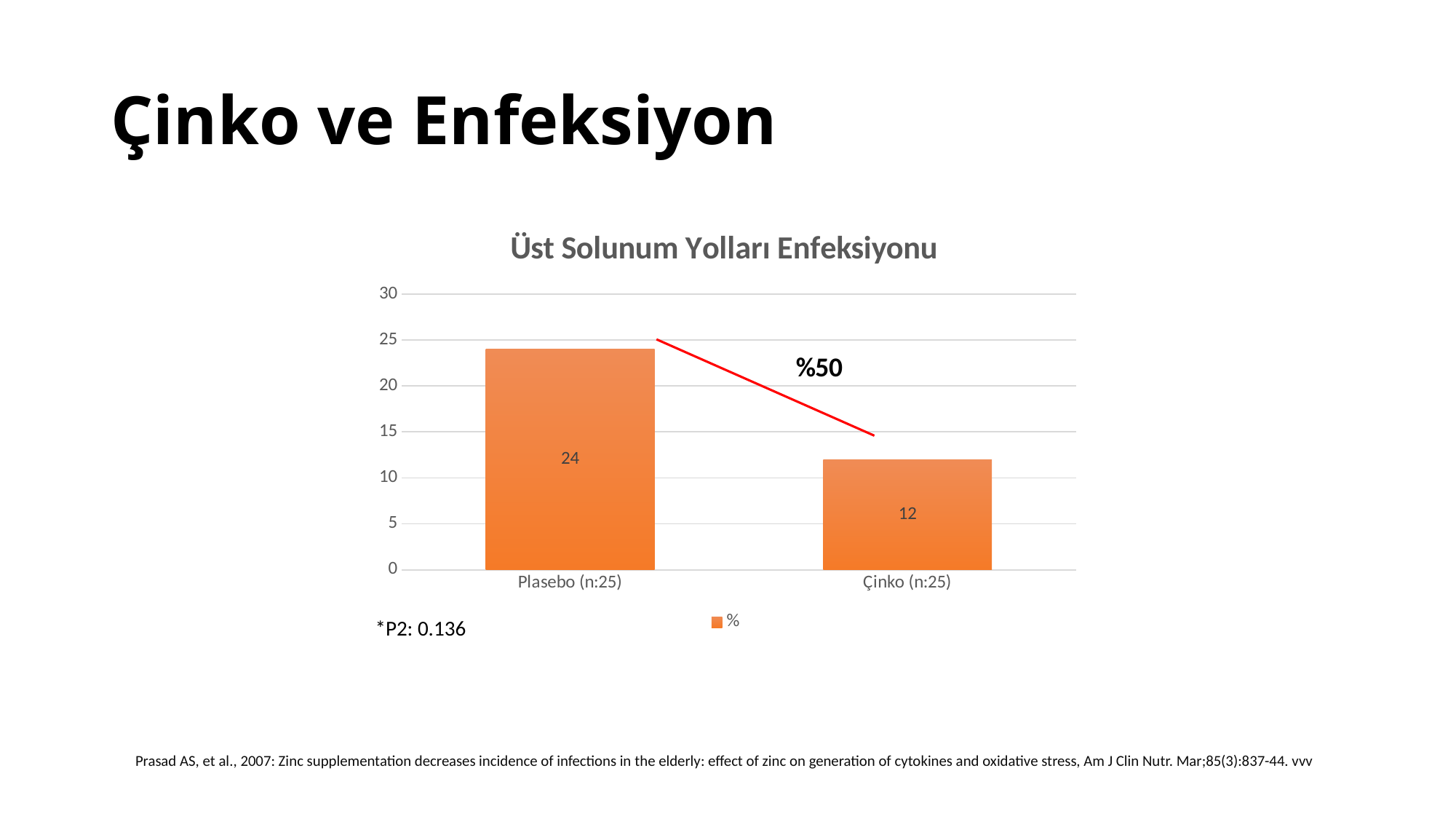
Which is larger, the value for Plasebo (n:25) or the value for Çinko (n:25)? Plasebo (n:25) What is the title of the chart? Üst Solunum Yolları Enfeksiyonu What is the value for Plasebo (n:25)? 24 Which category has the lowest value? Çinko (n:25) What is the difference between the values for Plasebo (n:25) and Çinko (n:25)? 12 Is the value for Çinko (n:25) greater or less than 15? less How many categories are shown on the x axis? 2 What kind of chart is shown on the slide? bar chart Is the value for Plasebo (n:25) greater or less than 20? greater How many series does the legend list? 1 Which category has the highest value? Plasebo (n:25) What is the value for Çinko (n:25)? 12